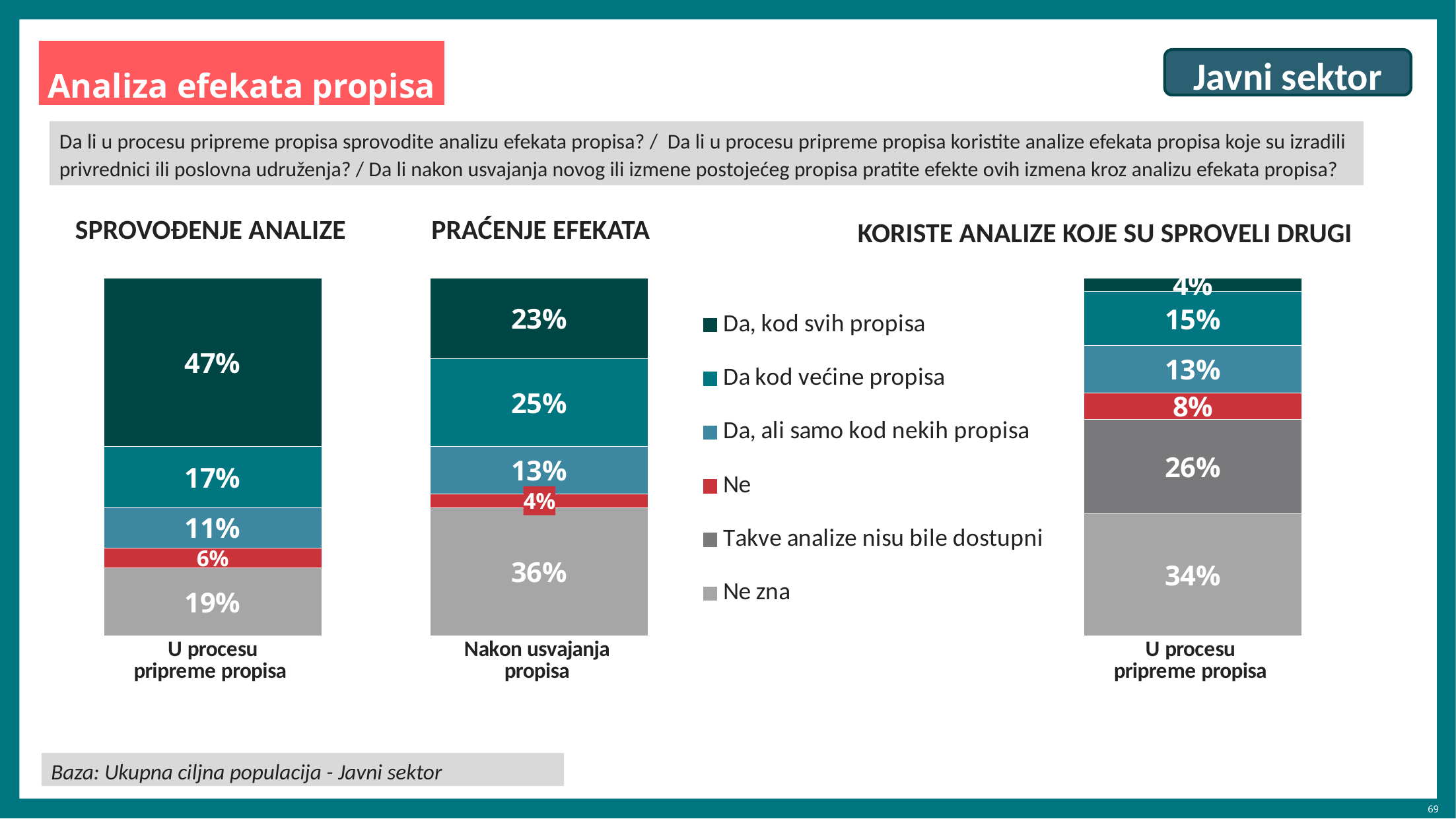
In the 'KORISTE ANALIZE KOJE SU SPROVELI DRUGI' chart, what is the value for 'Ne'? 8% In the 'PRAĆENJE EFEKATA' chart, which is larger: 'Da, kod svih propisa' or 'Da kod većine propisa'? Da kod većine propisa What is the total of the stacked bar in the 'KORISTE ANALIZE KOJE SU SPROVELI DRUGI' chart? 100% In the 'PRAĆENJE EFEKATA' chart, what is the value for 'Ne zna'? 36% In the 'SPROVOĐENJE ANALIZE' chart, which segment has the largest value? Da, kod svih propisa In the 'KORISTE ANALIZE KOJE SU SPROVELI DRUGI' chart, what is the value for 'Takve analize nisu bile dostupni'? 26% In the 'PRAĆENJE EFEKATA' chart, which segment has the smallest value? Ne What kind of chart is used on this slide? Stacked bar chart In the 'SPROVOĐENJE ANALIZE' chart, what is the difference between 'Da, kod svih propisa' and 'Da kod većine propisa'? 30 percentage points In the 'KORISTE ANALIZE KOJE SU SPROVELI DRUGI' chart, which segment has the smallest value? Da, kod svih propisa How many entries does the legend list? 6 In the 'SPROVOĐENJE ANALIZE' chart, what is the value for 'Da, kod svih propisa'? 47%